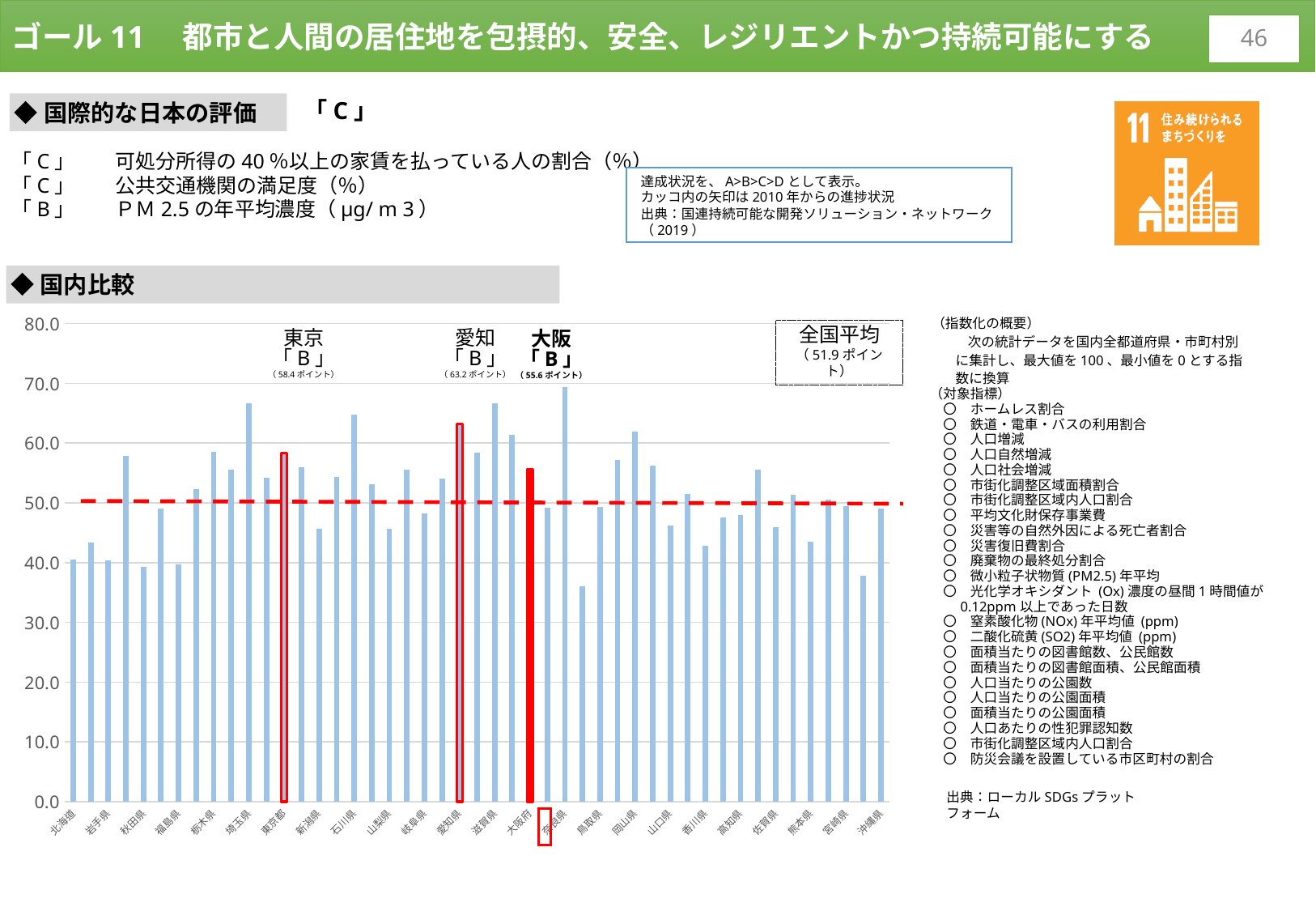
What is the value shown for 愛知 (Aichi) in the 国内比較 chart? 63.2 ポイント By how many points does 愛知 exceed 東京 in the chart? 4.8 What is the value shown for 東京 (Tokyo) in the 国内比較 chart? 58.4 ポイント Which has the higher value, 愛知 or 大阪? 愛知 Is the value for 東京 higher or lower than the 全国平均? higher What is the value shown for 大阪 (Osaka) in the 国内比較 chart? 55.6 ポイント What is the 全国平均 (national average) value shown on the chart? 51.9 ポイント Is the value for 北海道 greater or less than 50? less What is the difference between the values for 東京 and 大阪? 2.8 Is the value for 埼玉県 greater or less than 60? greater What kind of chart is used in the 国内比較 section? bar chart